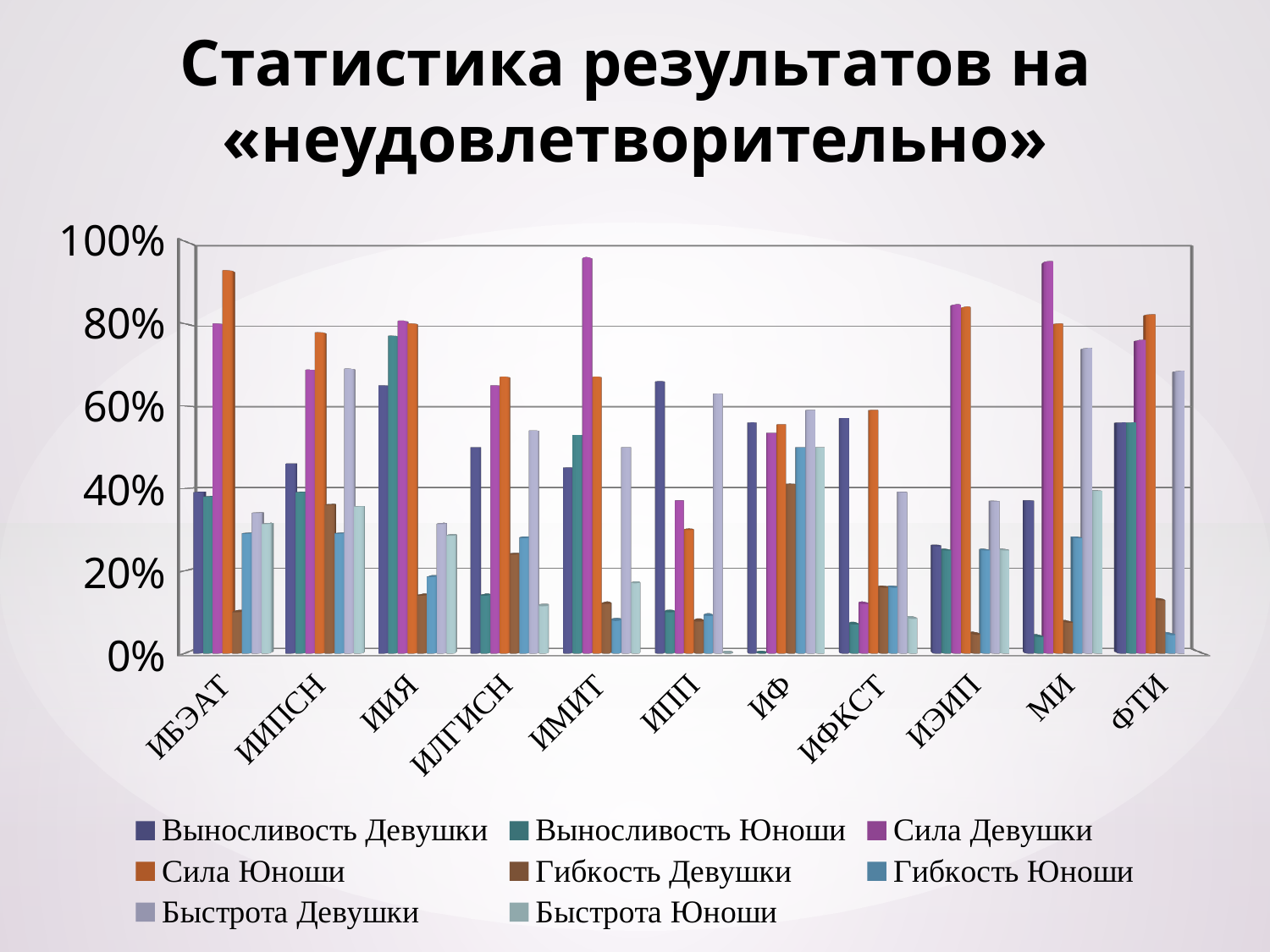
How many categories (institutes) are shown on the x axis? 11 Is the value for Сила Девушки at ИМИТ greater or less than 80%? greater How many series does the legend list? 8 Is the value for Сила Юноши at ИФКСТ greater or less than 40%? greater Is the value for Гибкость Девушки at ИБЭАТ greater or less than 20%? less What is the title of the chart? Статистика результатов на «неудовлетворительно» At ИБЭАТ, which is larger: Сила Юноши or Сила Девушки? Сила Юноши What kind of chart is shown on the slide? bar chart Which category has the lowest value for Сила Девушки? ИФКСТ Which category has the highest value for Сила Юноши? ИБЭАТ